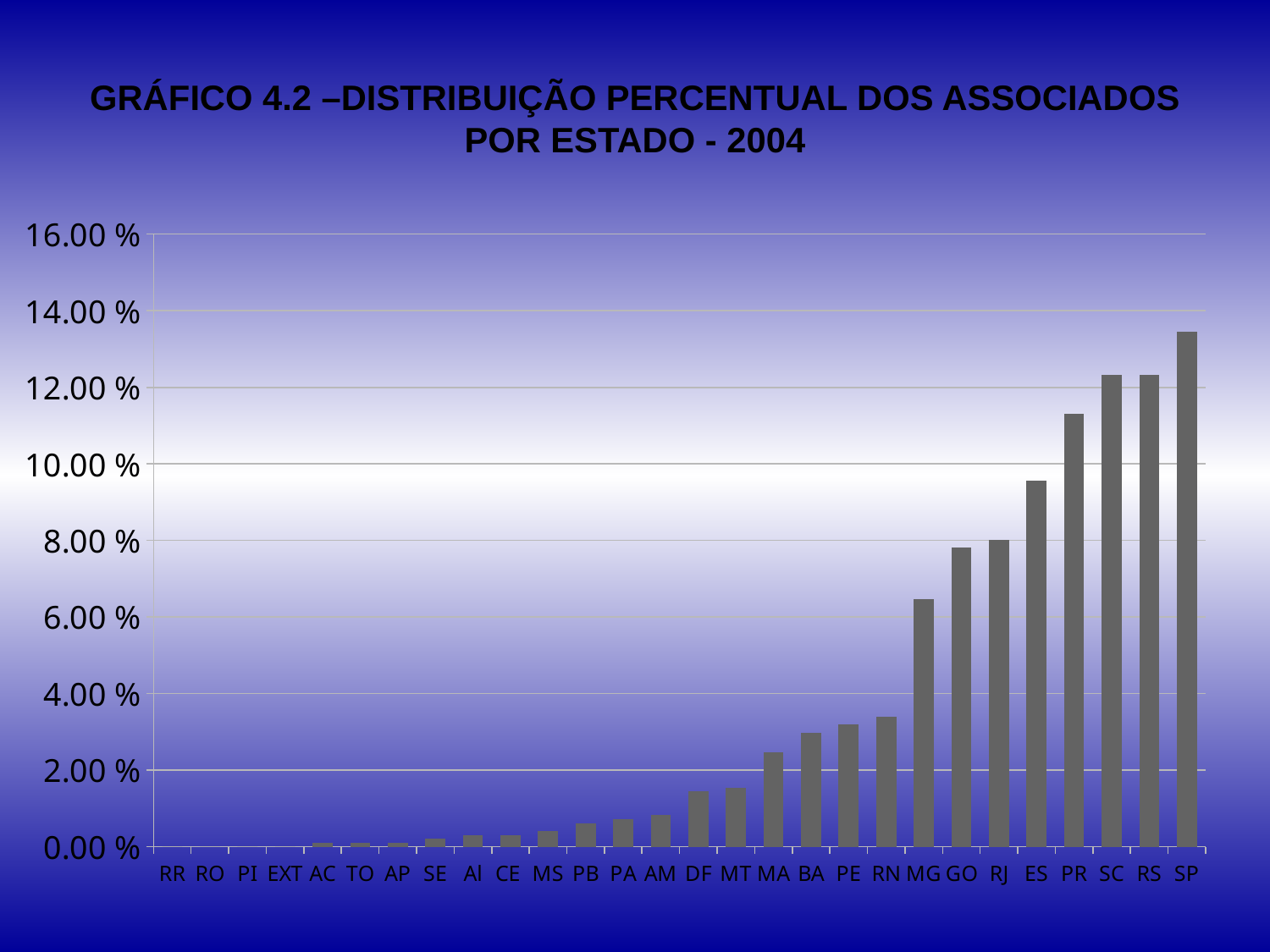
Do the values generally rise or fall from left to right along the x axis? rise Is the value for ES greater or less than 10.00 %? less Is the value for SP greater or less than 12.00 %? greater Which state has the highest percentage of associados in the chart? SP Is the value for PR greater or less than 10.00 %? greater Which is larger, the value for SP or the value for PR? SP What kind of chart is shown on the slide? bar chart How many categories are shown along the x axis of the chart? 28 What is the title of the chart? GRÁFICO 4.2 –DISTRIBUIÇÃO PERCENTUAL DOS ASSOCIADOS POR ESTADO - 2004